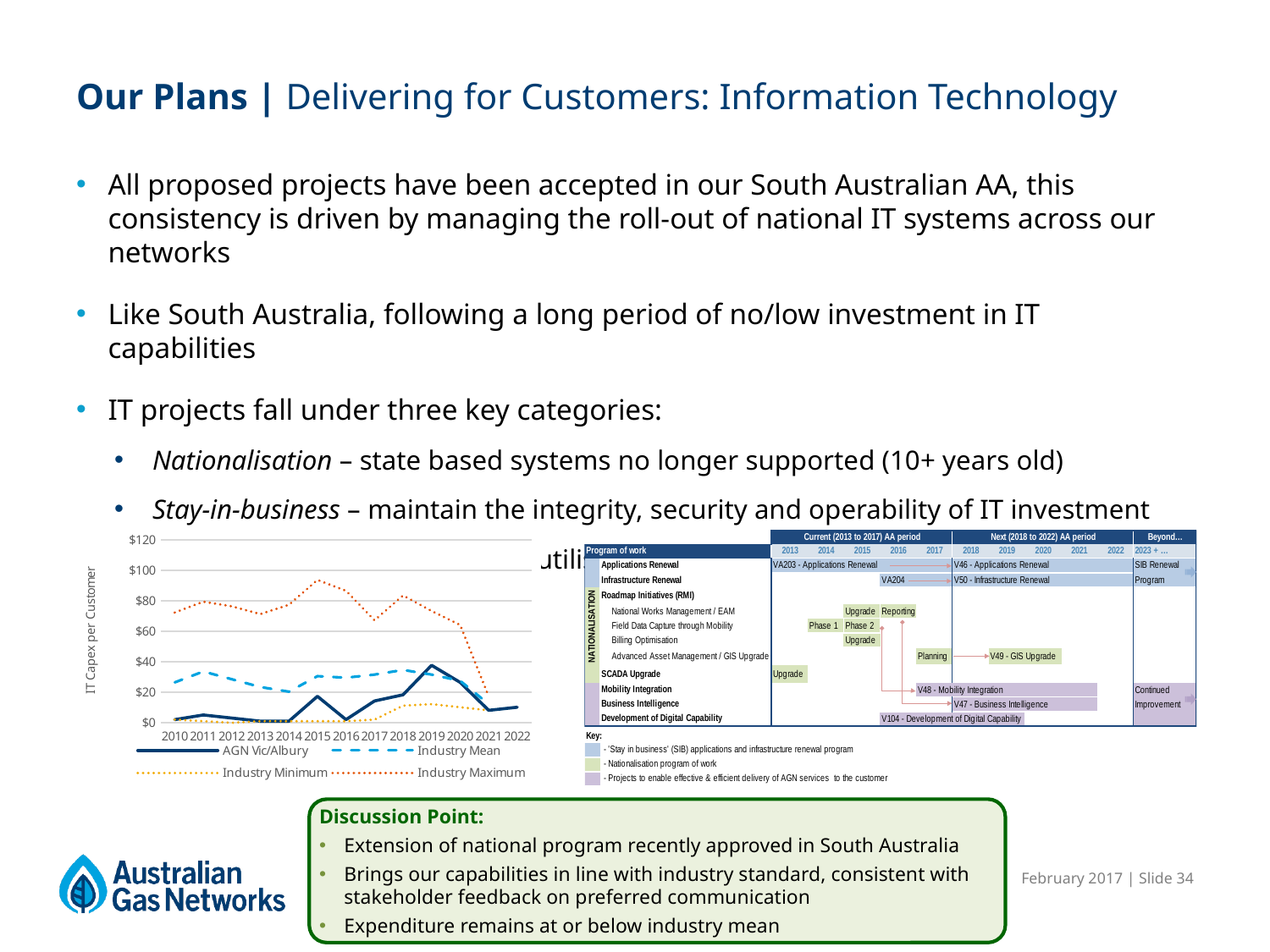
In the IT Capex per Customer line chart, is the AGN Vic/Albury value for 2019 greater or less than $20? greater How many years are shown on the x axis of the IT Capex per Customer line chart? 13 In the IT Capex per Customer line chart, which is larger in 2010: Industry Mean or AGN Vic/Albury? Industry Mean In the IT Capex per Customer line chart, is the Industry Mean value for 2011 greater or less than $20? greater How many series does the legend of the IT Capex per Customer line chart list? 4 In the IT Capex per Customer line chart, is the Industry Minimum value for 2015 greater or less than $20? less In the IT Capex per Customer line chart, which is larger in 2013: Industry Maximum or AGN Vic/Albury? Industry Maximum What is the label on the y axis of the line chart on the left of the slide? IT Capex per Customer What kind of chart is the IT Capex per Customer chart on the left of the slide? line chart